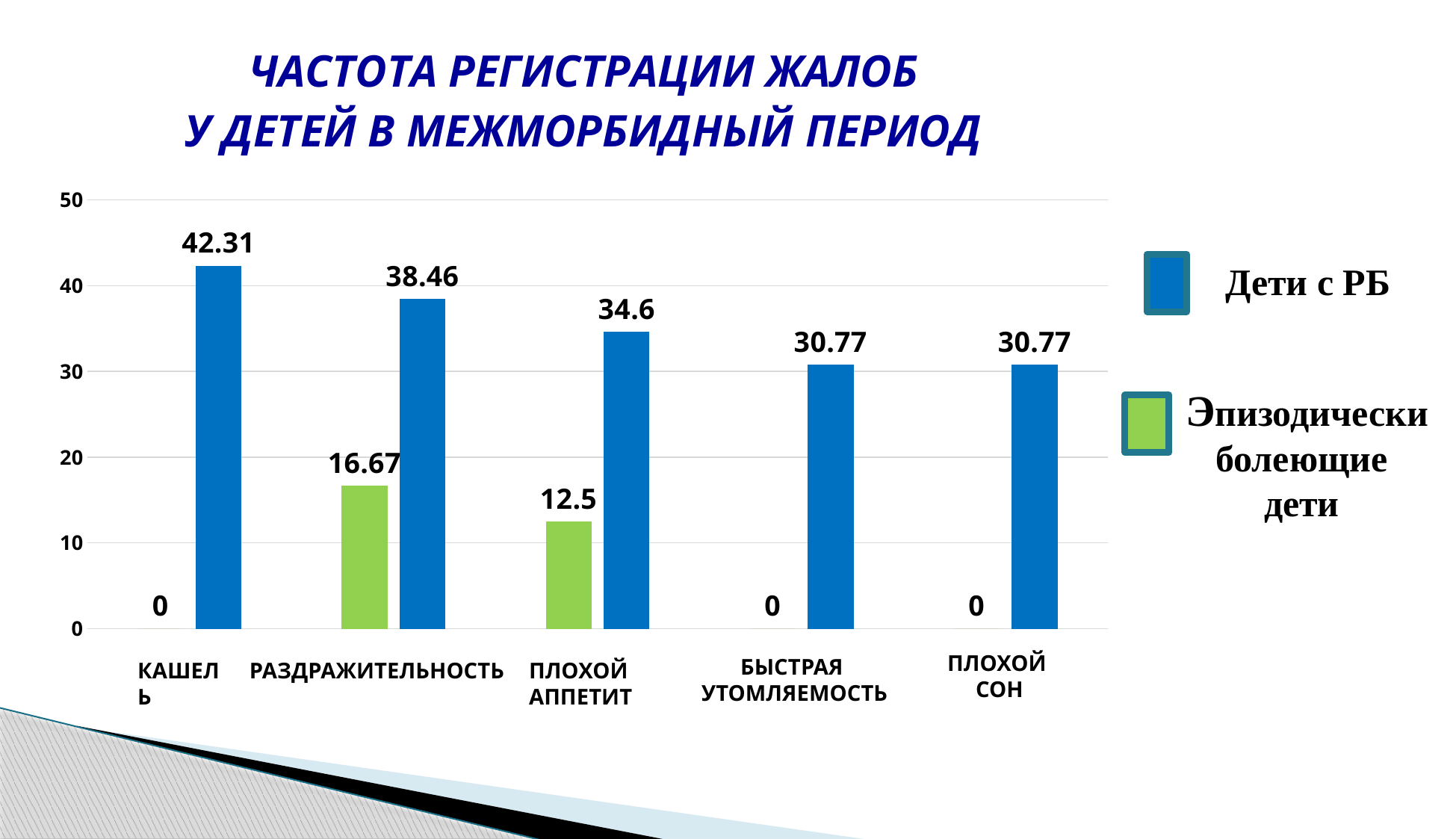
What is the value for Дети с РБ in the Кашель category? 42.31 What is the value for Эпизодически болеющие дети in the Раздражительность category? 16.67 What is the difference between Дети с РБ and Эпизодически болеющие дети in the Раздражительность category? 21.79 How many series does the legend list? 2 Which category has the highest value for Дети с РБ? Кашель What is the value for Дети с РБ in the Быстрая утомляемость category? 30.77 How many categories are shown on the x axis? 5 Which category has the highest value for Эпизодически болеющие дети? Раздражительность Which is larger in the Плохой аппетит category: Дети с РБ or Эпизодически болеющие дети? Дети с РБ Which colour represents Эпизодически болеющие дети in the legend? Green What is the value for Эпизодически болеющие дети in the Плохой аппетит category? 12.5 What kind of chart is shown on the slide? Bar chart